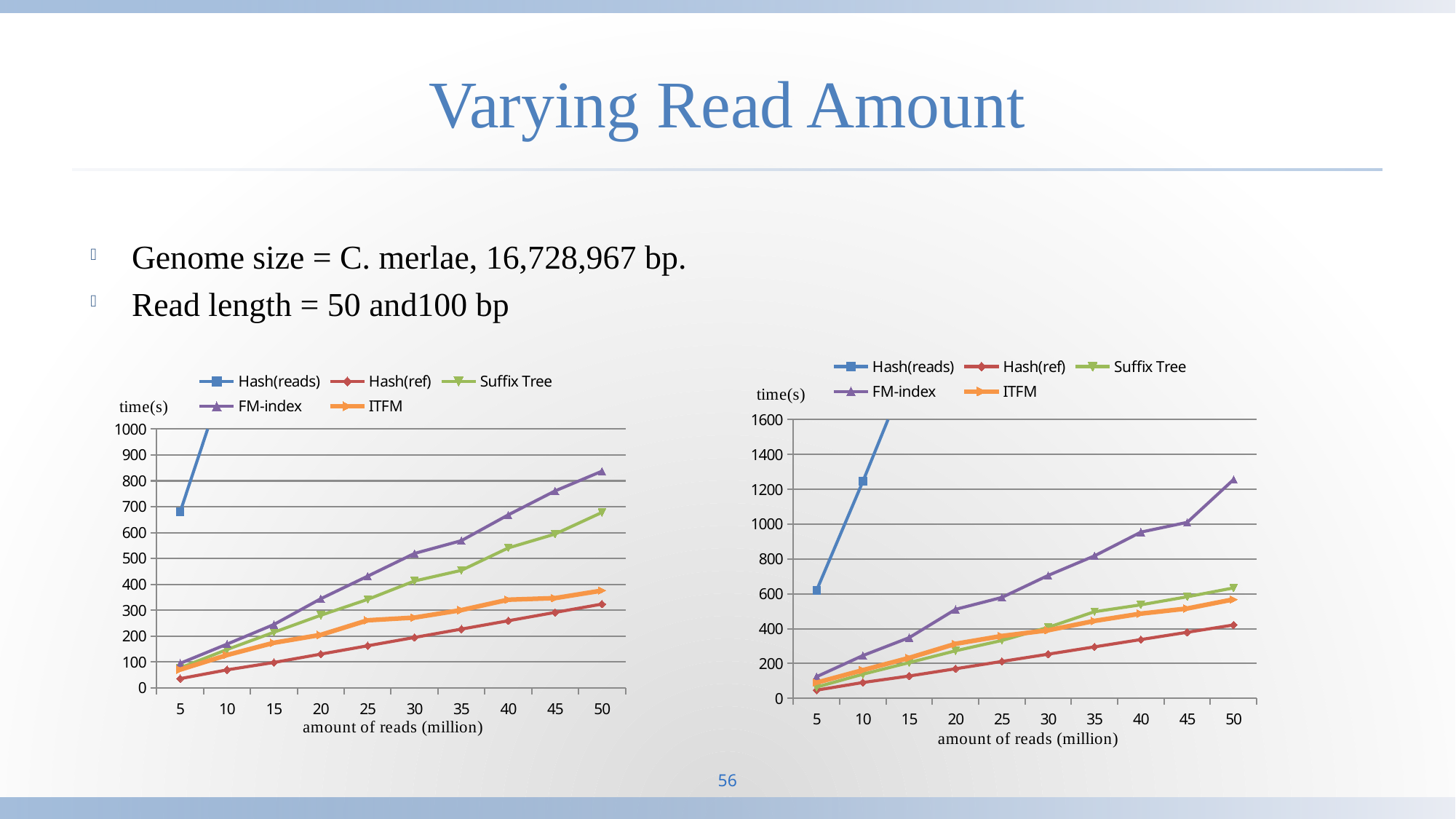
In the left chart, how many x-axis values (amounts of reads) are plotted? 10 In the right chart, is the FM-index value at 50 million reads greater or less than 1200? greater In the right chart, is the Hash(ref) value at 50 million reads greater or less than 500? less In the left chart, is the FM-index value at 50 million reads greater or less than 800? greater How many series does the legend of the right chart list? 5 In the left chart, which series has the lowest time at 50 million reads? Hash(ref) What kind of chart is the left chart on the slide? line chart What is the x-axis label of the right chart? amount of reads (million) In the left chart, which is larger at 50 million reads: Suffix Tree or ITFM? Suffix Tree In the right chart, which series has the highest time at 50 million reads? Hash(reads) In the right chart, does the FM-index time rise or fall as the amount of reads increases? rise